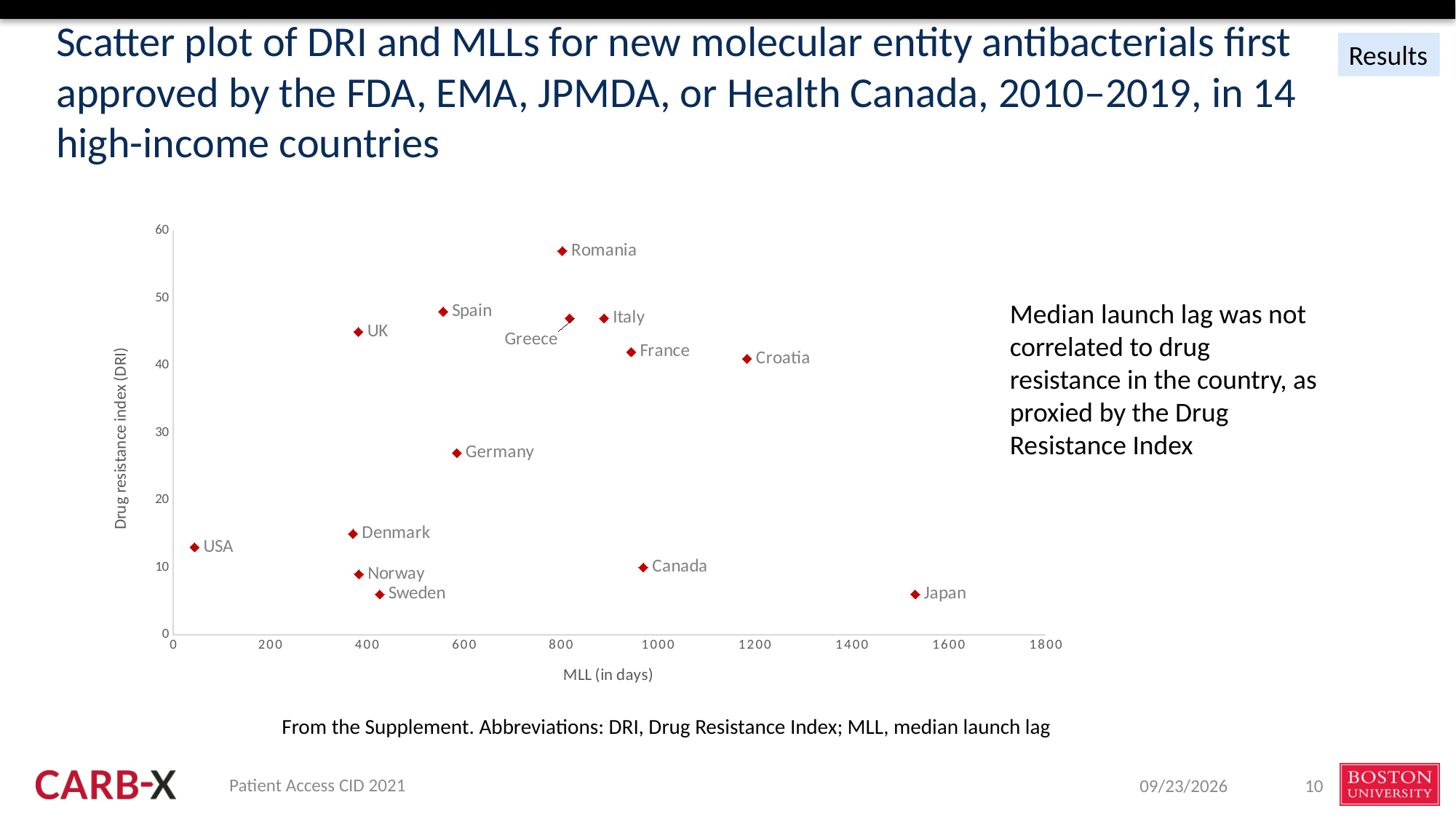
What kind of chart is shown on the slide? Scatter plot Is the MLL for Croatia greater or less than 1000 days? greater Which country has a higher MLL, Japan or Canada? Japan Which country has the lowest MLL (in days) on the scatter plot? USA Is the drug resistance index for Romania greater or less than 50? greater How many countries are plotted on the scatter plot? 14 Is the drug resistance index for Germany greater or less than 30? less Which country has the highest drug resistance index (DRI) on the scatter plot? Romania Which country has the highest MLL (in days) on the scatter plot? Japan Which country has a higher drug resistance index, Romania or Italy? Romania What is the label of the x axis of the scatter plot? MLL (in days)